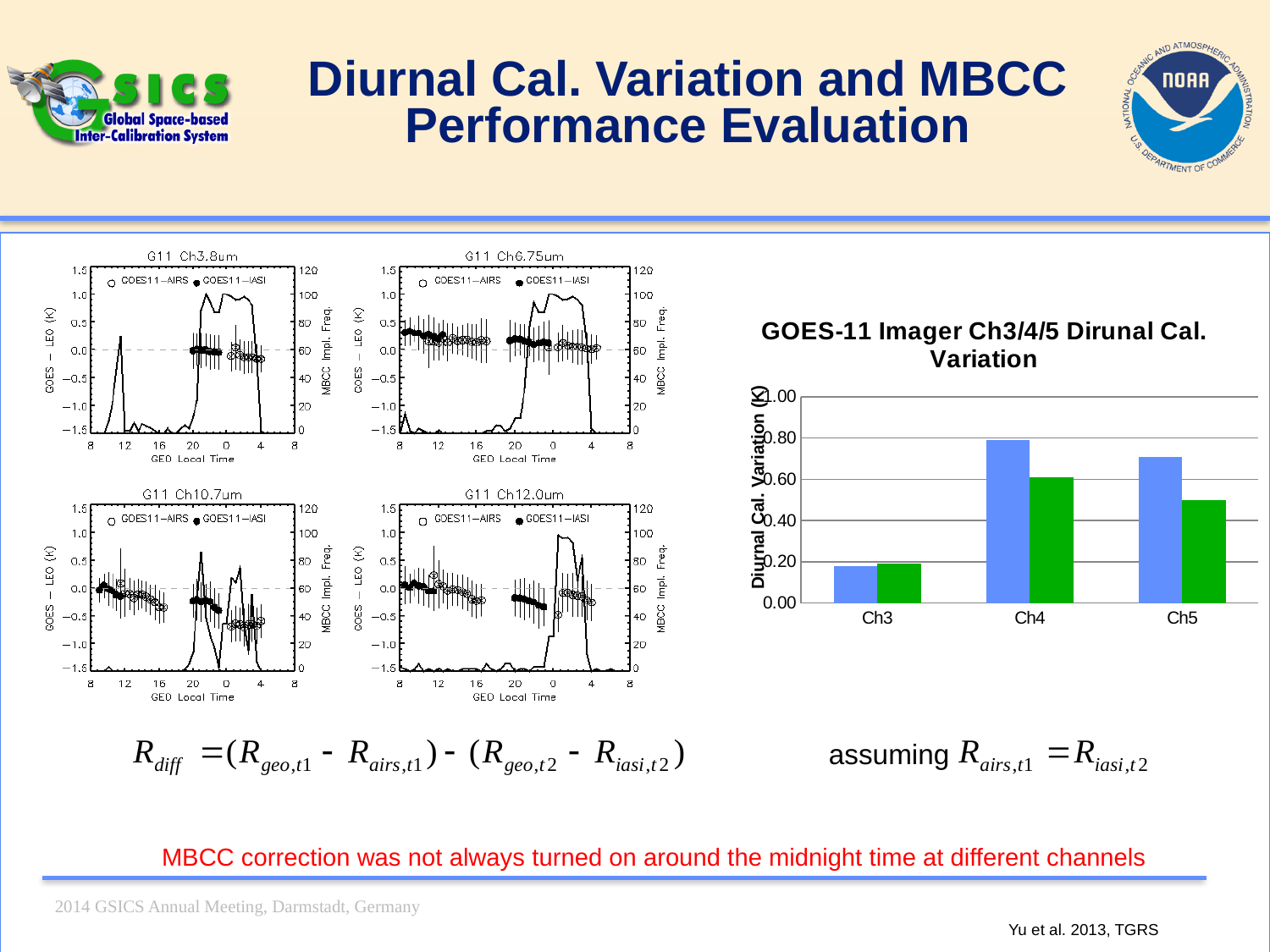
In the 'GOES-11 Imager Ch3/4/5 Dirunal Cal. Variation' bar chart, which channel has the tallest blue bar? Ch4 In the 'GOES-11 Imager Ch3/4/5 Dirunal Cal. Variation' bar chart, which channel has the tallest green bar? Ch4 What is the y-axis label of the 'GOES-11 Imager Ch3/4/5 Dirunal Cal. Variation' bar chart? Diurnal Cal. Variation (K) What kind of chart is the 'GOES-11 Imager Ch3/4/5 Dirunal Cal. Variation' chart? bar chart In the 'GOES-11 Imager Ch3/4/5 Dirunal Cal. Variation' bar chart, for Ch5, which bar is taller, the blue one or the green one? the blue one In the 'GOES-11 Imager Ch3/4/5 Dirunal Cal. Variation' bar chart, is the blue bar for Ch4 greater or less than 0.60? greater In the 'GOES-11 Imager Ch3/4/5 Dirunal Cal. Variation' bar chart, is the blue bar for Ch3 greater or less than 0.40? less In the 'GOES-11 Imager Ch3/4/5 Dirunal Cal. Variation' bar chart, for Ch4, which bar is taller, the blue one or the green one? the blue one What are the two legend entries shown in the 'G11 Ch3.8um' line plot on the left of the slide? GOES11-AIRS and GOES11-IASI In the 'GOES-11 Imager Ch3/4/5 Dirunal Cal. Variation' bar chart, is the green bar for Ch5 greater or less than 0.40? greater How many channel categories are shown on the x axis of the 'GOES-11 Imager Ch3/4/5 Dirunal Cal. Variation' bar chart? 3 In the 'GOES-11 Imager Ch3/4/5 Dirunal Cal. Variation' bar chart, which channel has the shortest green bar? Ch3